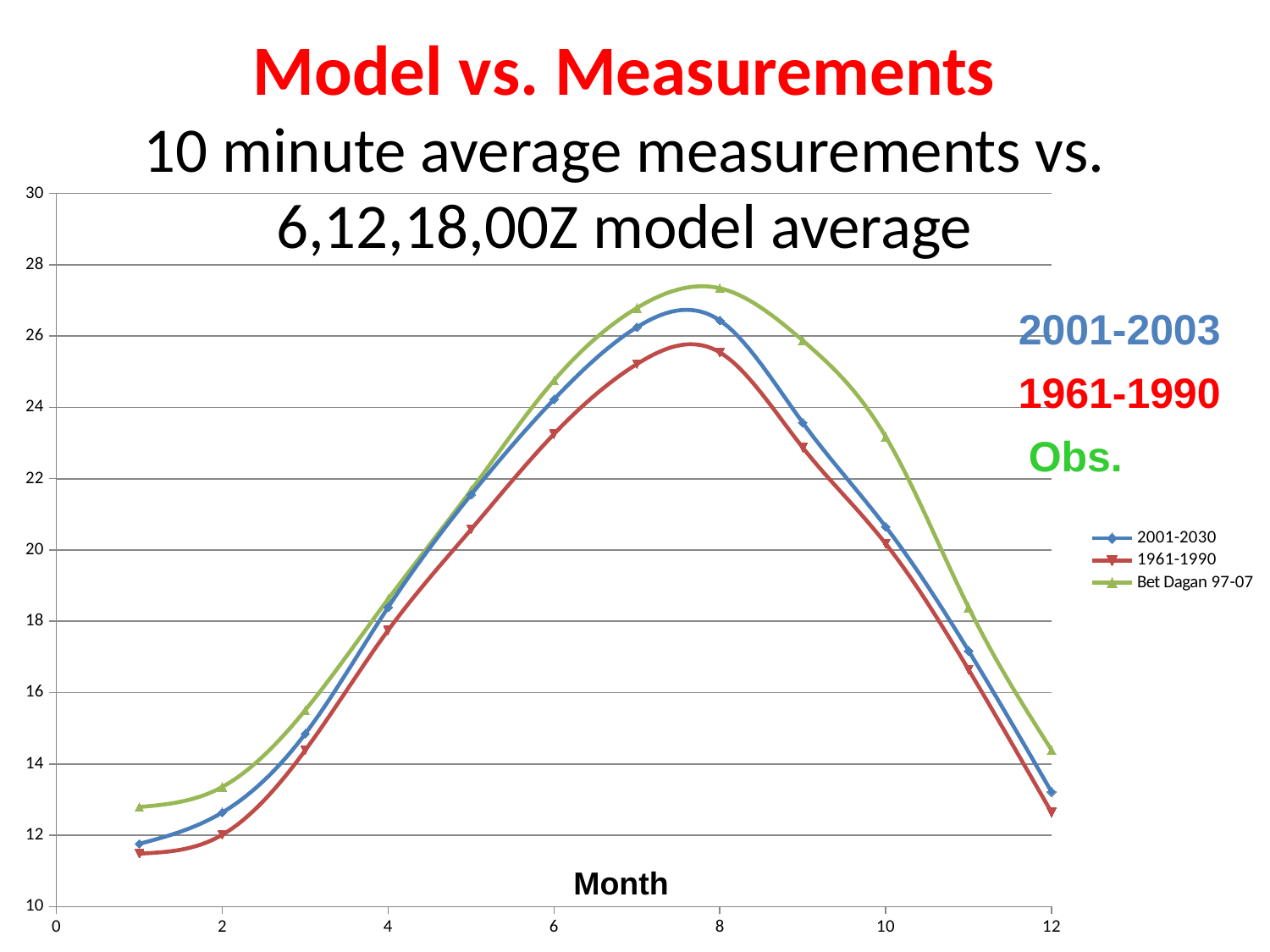
Is the value for 1961-1990 at month 11 greater or less than 18? less At month 12, which series has the higher value, 2001-2030 or 1961-1990? 2001-2030 Do the values of the 2001-2030 series rise or fall from month 1 to month 7? rise Is the value for Bet Dagan 97-07 at month 8 greater or less than 26? greater What is the title of the x axis? Month Do the values of the Bet Dagan 97-07 series rise or fall from month 8 to month 12? fall How many series does the legend list? 3 At month 8, which series has the higher value, Bet Dagan 97-07 or 2001-2030? Bet Dagan 97-07 Is the value for 1961-1990 at month 1 greater or less than 12? less How many monthly data points are plotted for each series? 12 In which month does the 2001-2030 series reach its lowest value? Month 1 What kind of chart is shown on the slide? line chart